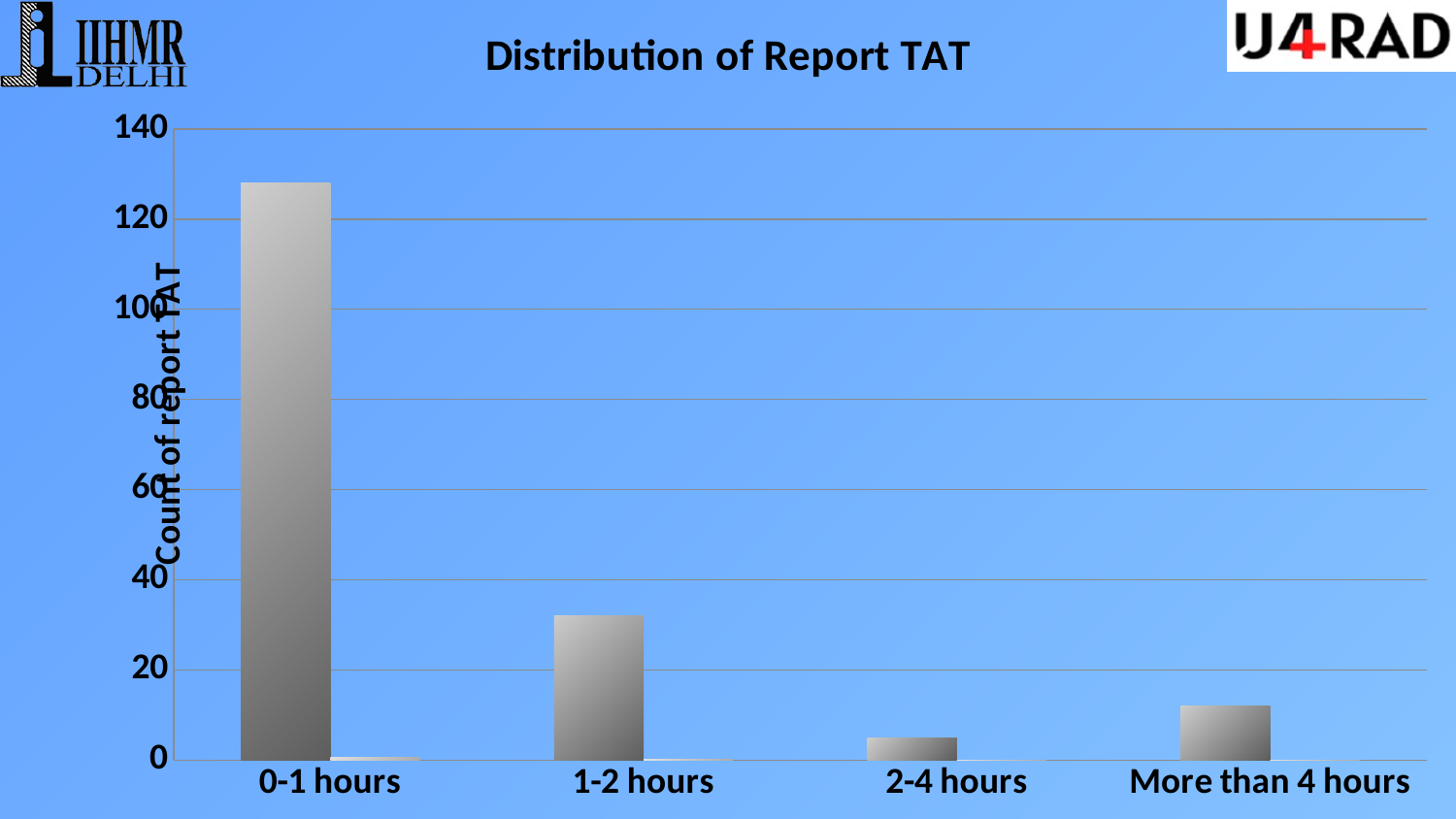
Is the value for 2-4 hours greater or less than 20? less Is the value for 1-2 hours greater or less than 40? less How many categories are shown on the x axis of the chart? 4 What is the label on the vertical axis of the chart? Count of report TAT Which is larger, the value for 2-4 hours or the value for More than 4 hours? More than 4 hours What kind of chart is shown on the slide? bar chart Which is larger, the value for 1-2 hours or the value for More than 4 hours? 1-2 hours Is the value for 0-1 hours greater or less than 120? greater What is the title of the chart? Distribution of Report TAT Which category has the highest count of report TAT? 0-1 hours Which category has the lowest count of report TAT? 2-4 hours